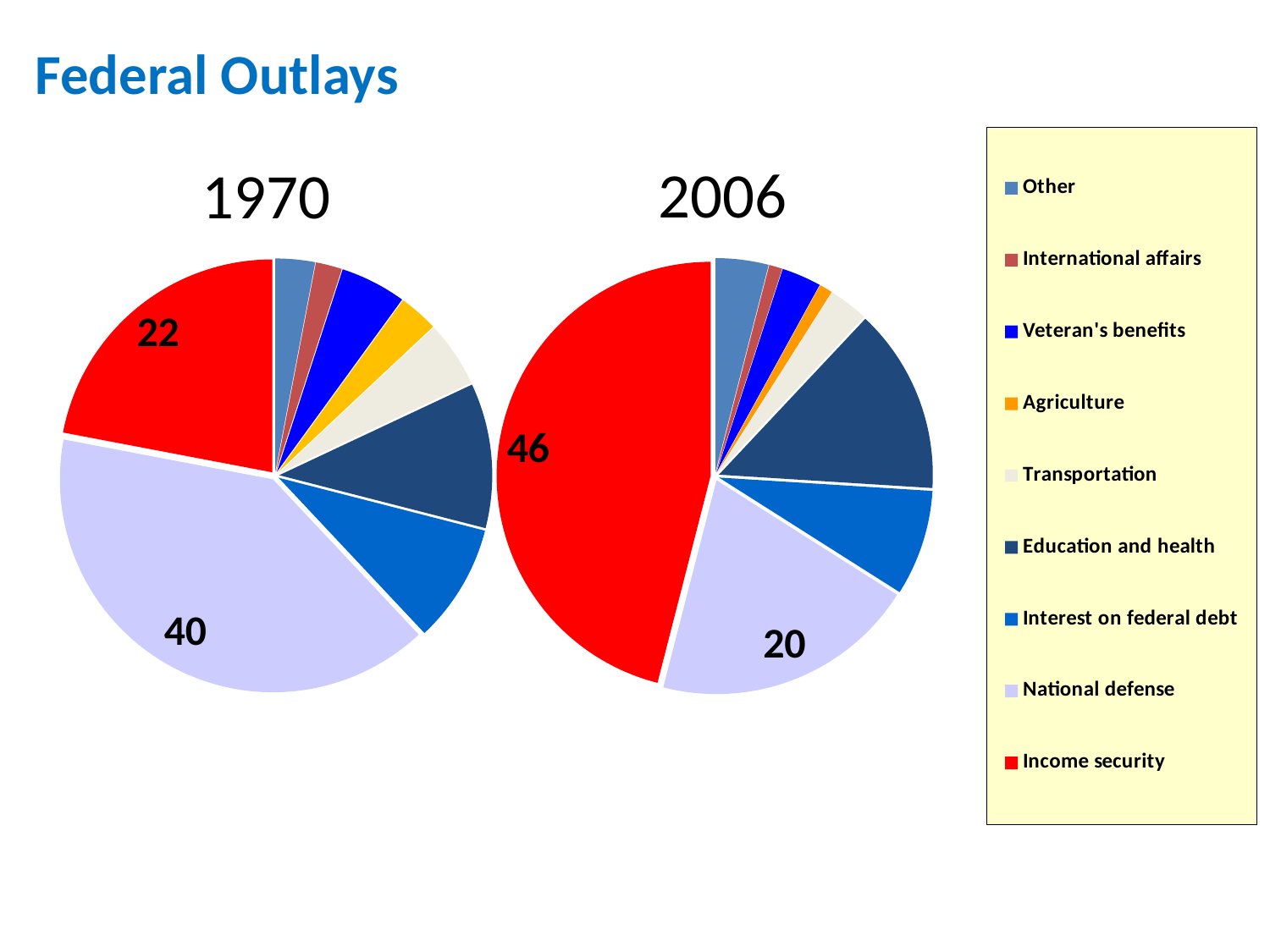
In the 2006 pie chart, what is the value for Income security? 46 In the 2006 pie chart, what is the value for National defense? 20 In the 1970 pie chart, which category has the largest slice? National defense In the 2006 pie chart, which category has the largest slice? Income security In the 2006 pie chart, what is the difference between the Income security value and the National defense value? 26 What kind of chart is used for the 1970 and 2006 data? Pie chart Comparing the two pie charts, is the Income security value larger in 1970 or in 2006? 2006 How many categories does the legend list? 9 What is the title of the slide containing the two pie charts? Federal Outlays In the 1970 pie chart, what is the value for Income security? 22 In the 1970 pie chart, what is the value for National defense? 40 In the 1970 pie chart, what is the difference between the National defense value and the Income security value? 18